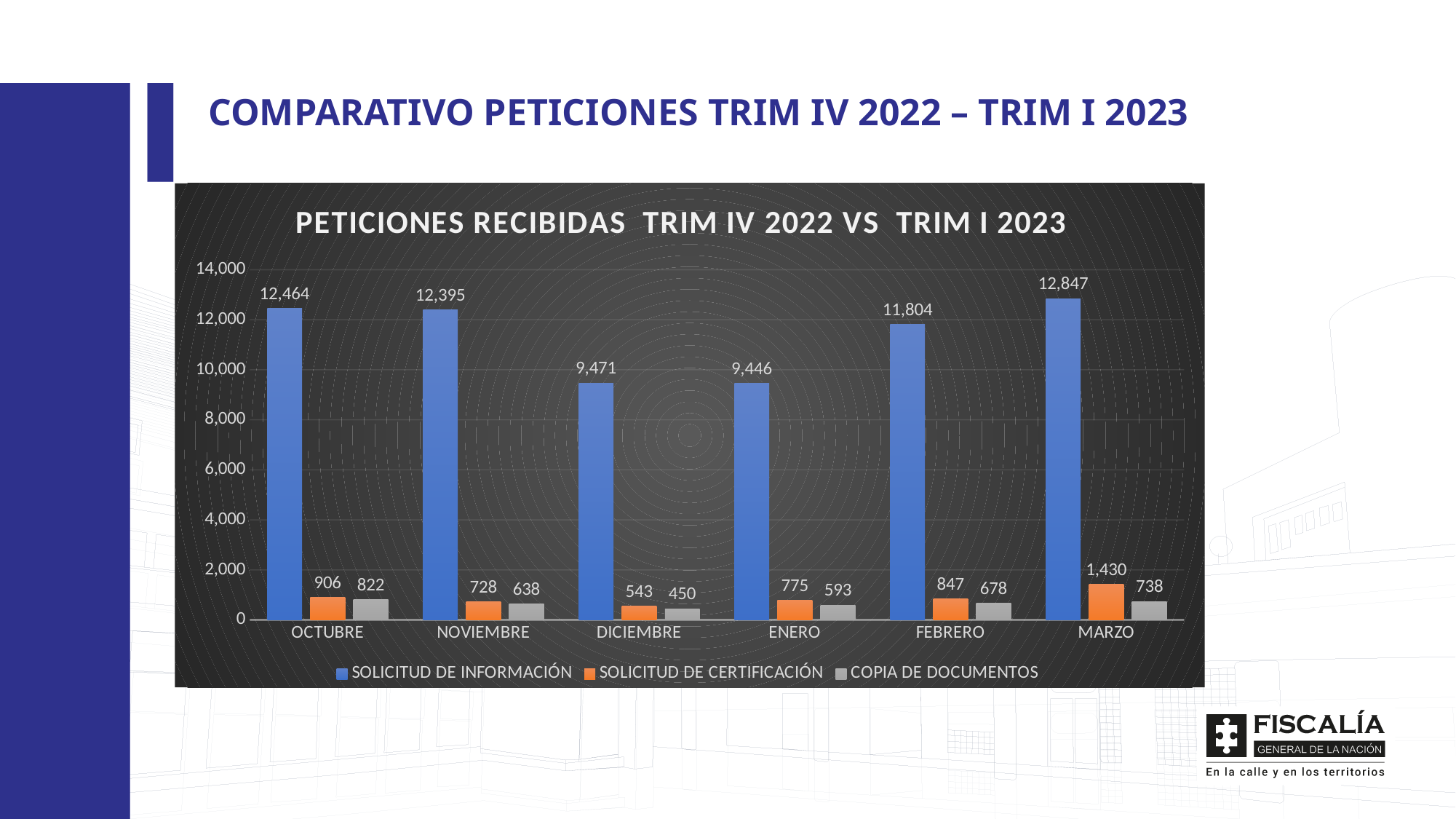
What is the title of the chart? PETICIONES RECIBIDAS TRIM IV 2022 VS TRIM I 2023 What is the value of COPIA DE DOCUMENTOS for DICIEMBRE? 450 Is the value of SOLICITUD DE INFORMACIÓN for DICIEMBRE greater or less than 10,000? less Which month has the lowest value for SOLICITUD DE CERTIFICACIÓN? DICIEMBRE Which is larger, COPIA DE DOCUMENTOS in ENERO or in FEBRERO? FEBRERO How many series does the legend list? 3 Which month has the highest value for SOLICITUD DE INFORMACIÓN? MARZO What is the value of SOLICITUD DE INFORMACIÓN for OCTUBRE? 12,464 What is the difference between SOLICITUD DE INFORMACIÓN in MARZO and in FEBRERO? 1,043 How many months are shown on the x axis? 6 What kind of chart is shown? Bar chart What is the value of SOLICITUD DE CERTIFICACIÓN for MARZO? 1,430